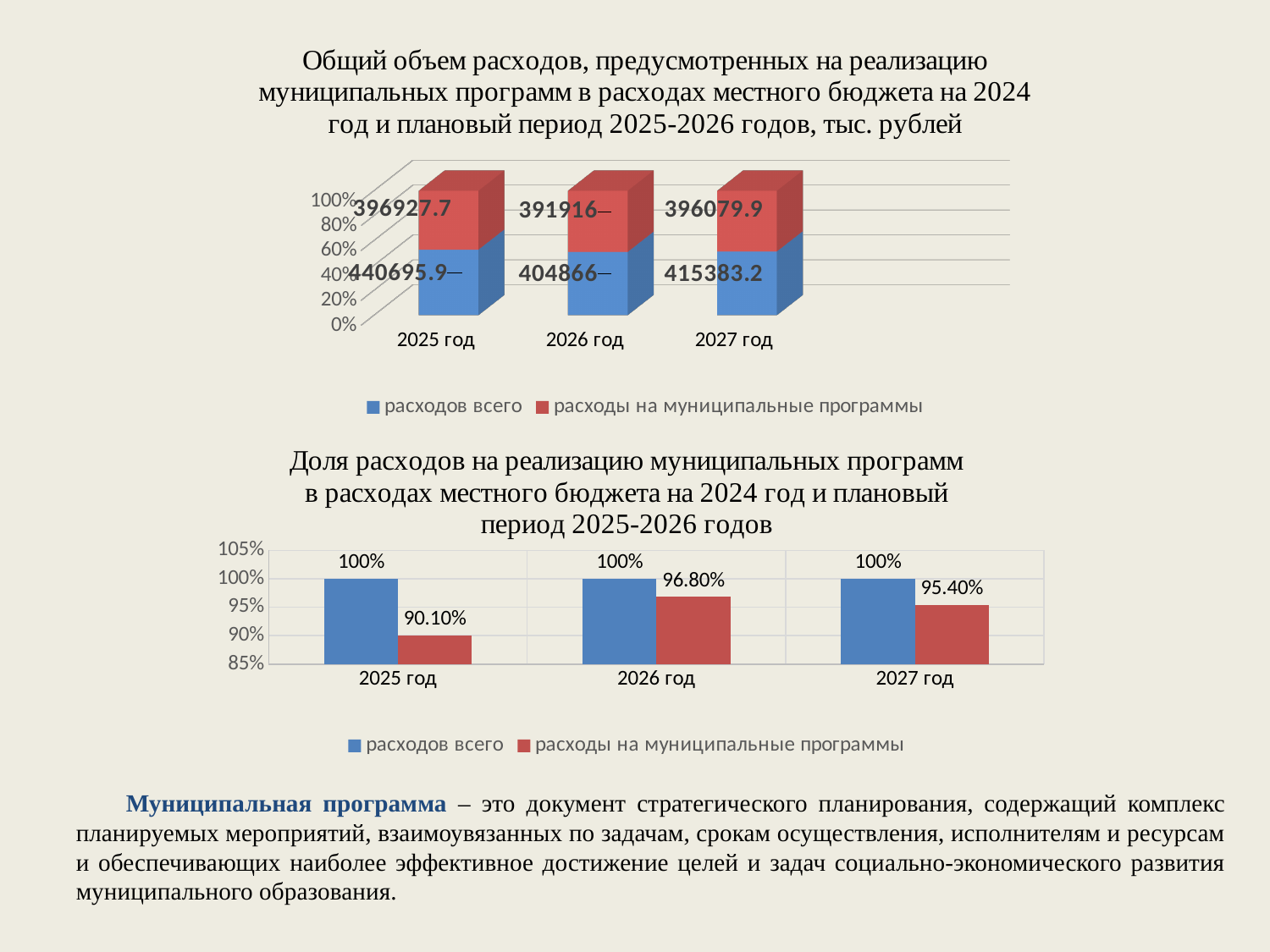
In the bottom chart, what is the difference between расходов всего and расходы на муниципальные программы in 2025 год? 9.90% In the top chart, which year has the lowest value for расходы на муниципальные программы? 2026 год In the top chart, which year has the highest value for расходов всего? 2025 год In the top chart, what is the value for расходы на муниципальные программы in 2027 год? 396079.9 How many series does the legend of the bottom chart list? 2 In the bottom chart, what is the value for расходы на муниципальные программы in 2025 год? 90.10% What kind of chart is the bottom chart? Bar chart In the bottom chart, which year has the highest value for расходы на муниципальные программы? 2026 год In the top chart, what is the value for расходов всего in 2025 год? 440695.9 In the top chart, what is the difference between расходов всего and расходы на муниципальные программы in 2026 год? 12950 In the top chart, what is the value for расходы на муниципальные программы in 2026 год? 391916 In the bottom chart, what is the value for расходы на муниципальные программы in 2027 год? 95.40%